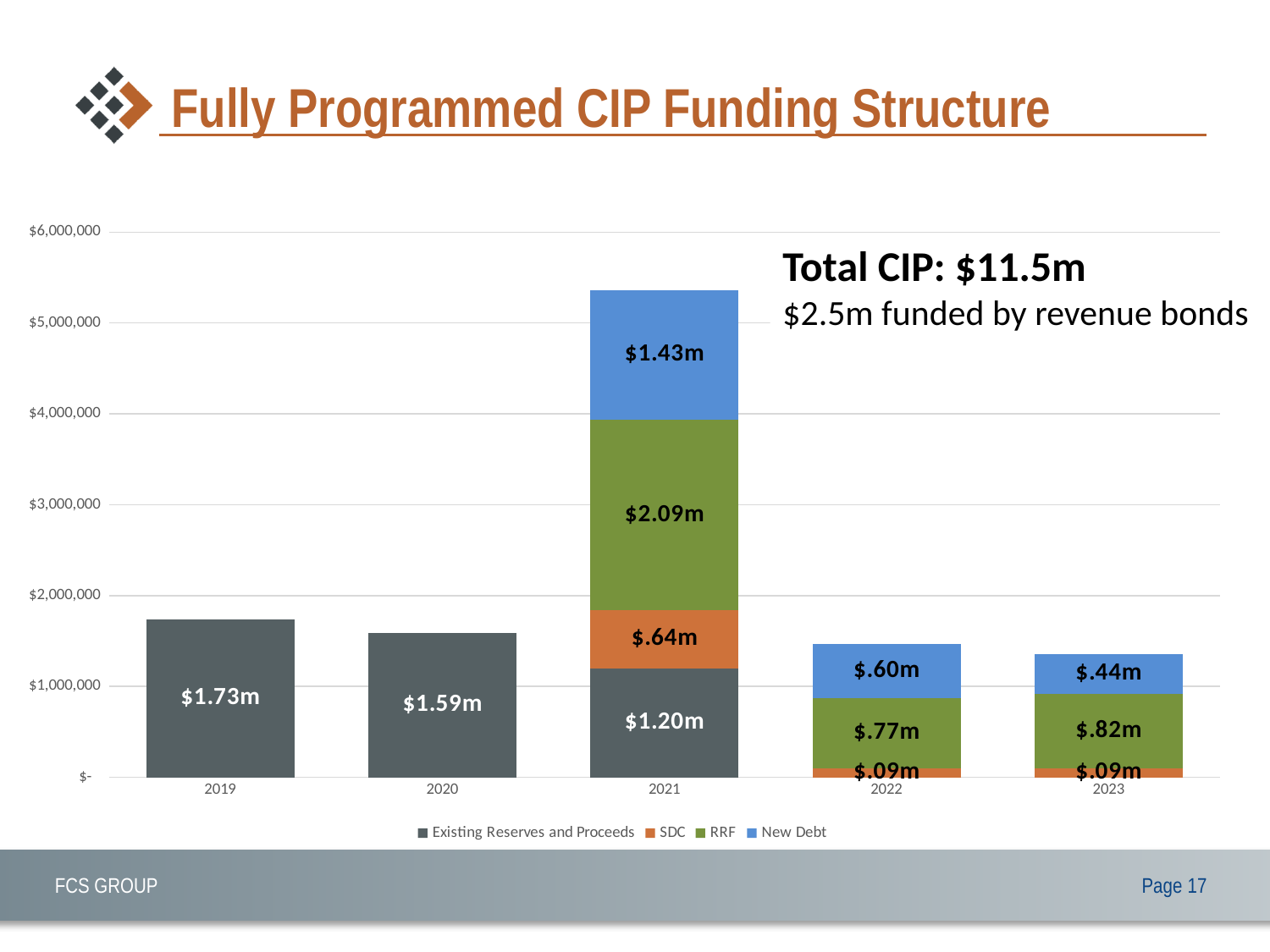
What is the value of Existing Reserves and Proceeds for 2019? $1.73m What is the total of the stacked bar for 2021? $5.36m How many series does the legend list? 4 What Total CIP amount is stated in the text on the chart? $11.5m What kind of chart is shown on the slide? stacked bar chart How many years are shown on the x axis? 5 Which year has the larger New Debt value, 2022 or 2023? 2022 Which year has the tallest stacked bar? 2021 What is the New Debt value for 2021? $1.43m Is the total of the 2021 bar greater or less than $5,000,000? greater What is the difference between the RRF value in 2021 and the RRF value in 2022? $1.32m What is the RRF value for 2023? $.82m